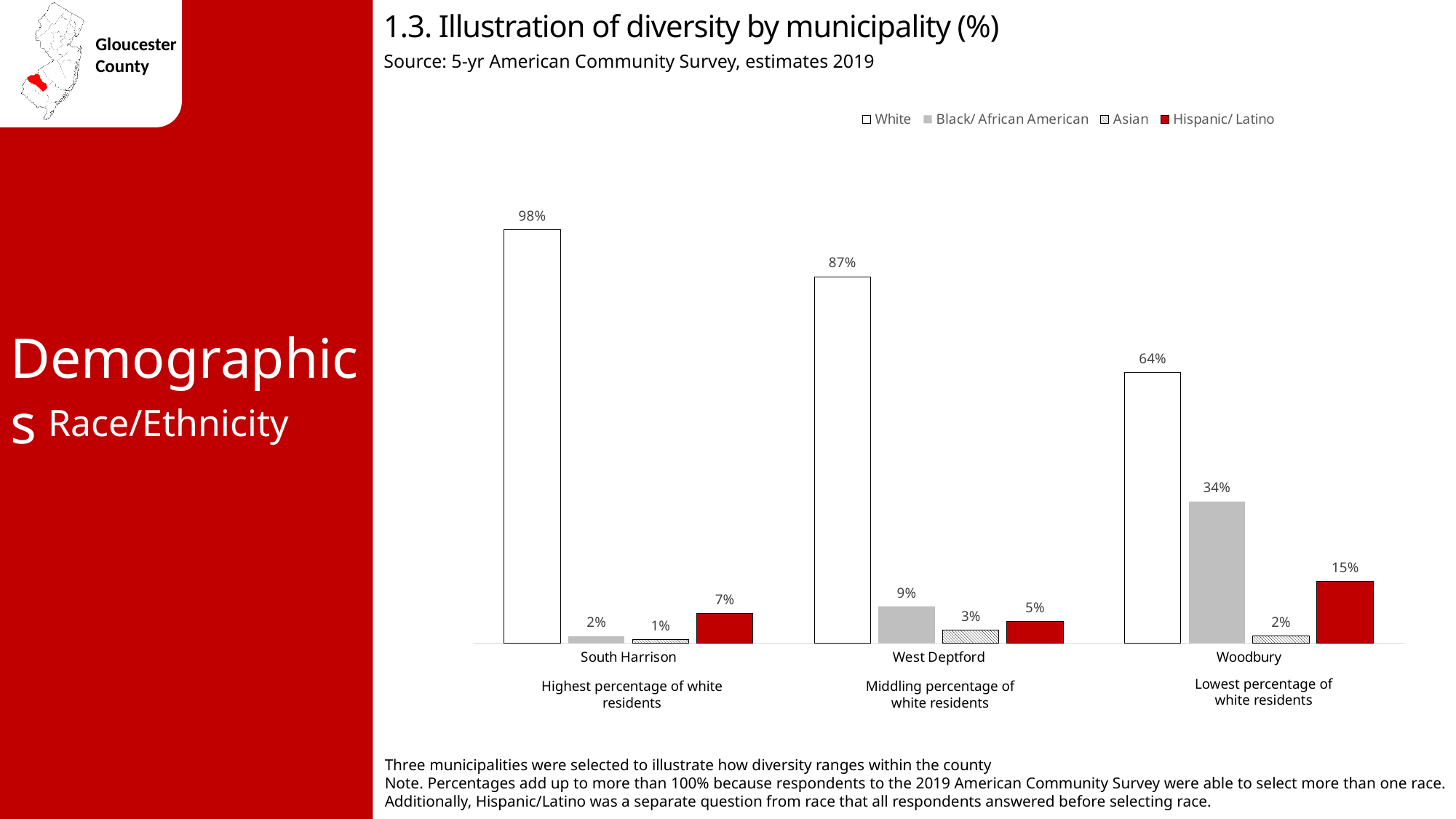
Which municipality has the highest Hispanic/Latino percentage? Woodbury What is the Hispanic/Latino percentage for West Deptford? 5% How many municipalities are shown on the chart? 3 What is the Black/African American percentage for Woodbury? 34% How many series does the legend list? 4 Which is larger: the Black/African American percentage in West Deptford or the Hispanic/Latino percentage in West Deptford? Black/African American What is the Asian percentage for South Harrison? 1% What kind of chart is shown on the slide? Bar chart Which municipality has the lowest White percentage? Woodbury Which series is shown in red on the chart? Hispanic/ Latino What is the difference between the White percentage in South Harrison and in Woodbury? 34% What percentage of South Harrison residents are White? 98%